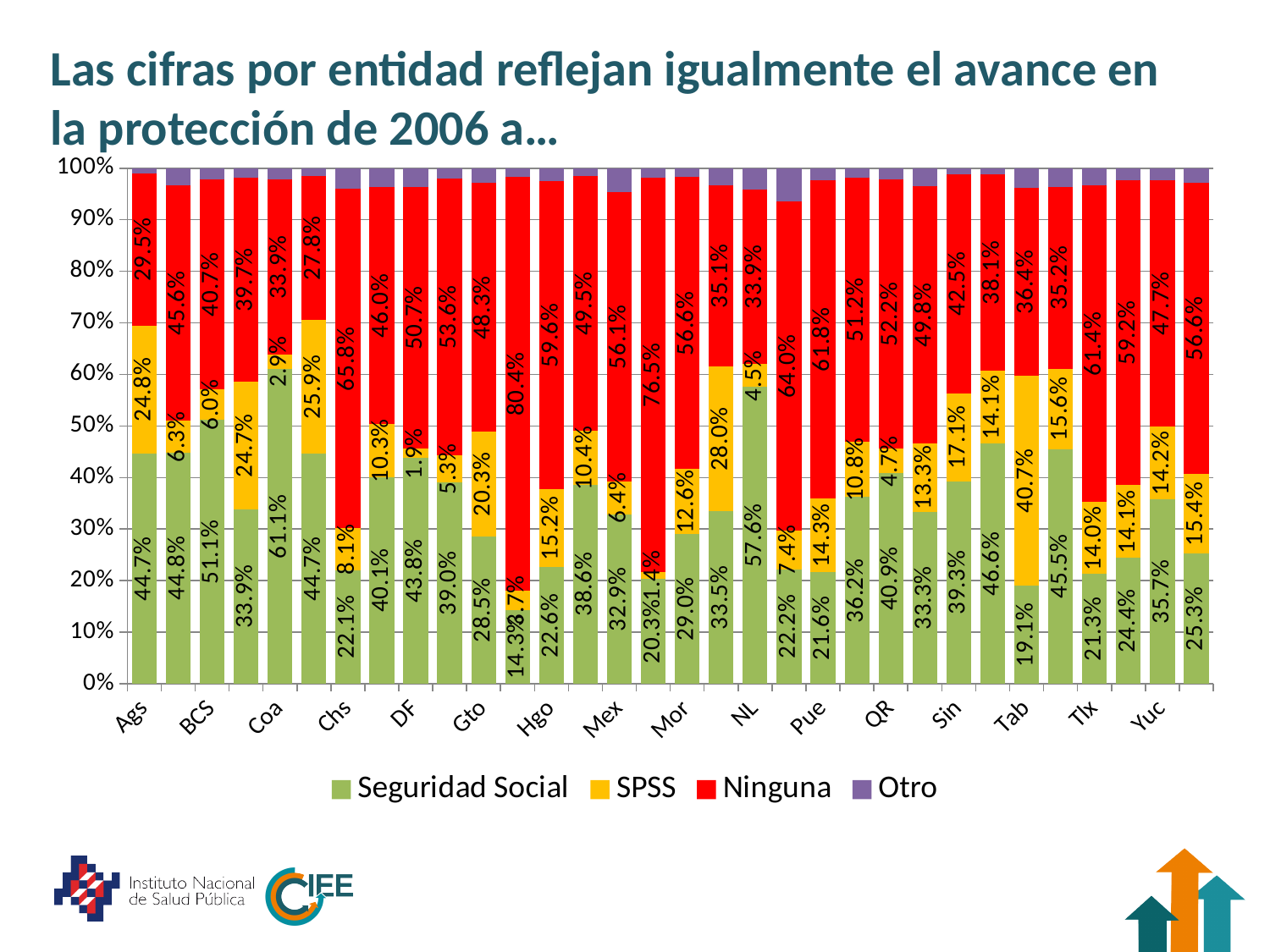
Is the Seguridad Social value for NL greater or less than 50%? greater What is the SPSS value for DF? 1.9% What is the SPSS value for Tab? 40.7% How many series does the legend list? 4 What is the Ninguna value for Chs? 65.8% Which has a larger Seguridad Social value, Ags or BCS? BCS What colour represents the Ninguna series in the legend? Red Which has a larger Ninguna value, Hgo or Mex? Hgo What is the difference between the Ninguna values for DF and Ags? 21.2 percentage points Among the labelled states, which has the highest Seguridad Social value? Coa What is the Seguridad Social value for Coa? 61.1% What kind of chart is shown on the slide? Stacked bar chart